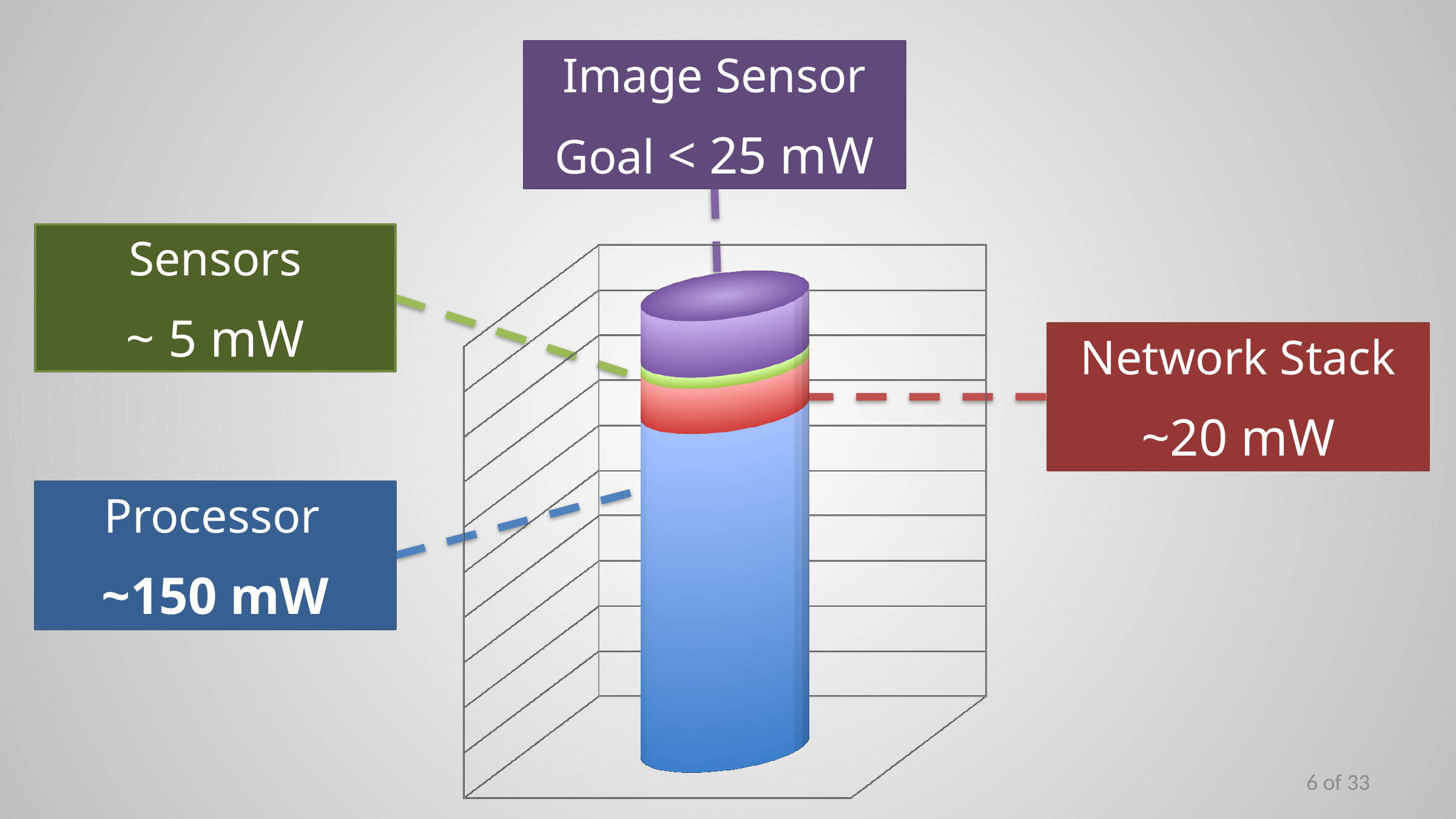
What power value is labelled for the Network Stack segment? ~20 mW What power value is labelled for the Sensors segment? ~ 5 mW What colour is the Image Sensor segment at the top of the bar? purple What colour is the Processor segment of the bar? blue Which is larger, the Processor segment or the Network Stack segment? Processor What power value is labelled for the Processor segment? ~150 mW Which component has the smallest segment in the stacked bar? Sensors How many segments make up the stacked bar? 4 Which component has the largest segment in the stacked bar? Processor What goal is stated for the Image Sensor segment? Goal < 25 mW Which is larger, the Network Stack segment or the Sensors segment? Network Stack What kind of chart is shown on the slide? stacked bar chart